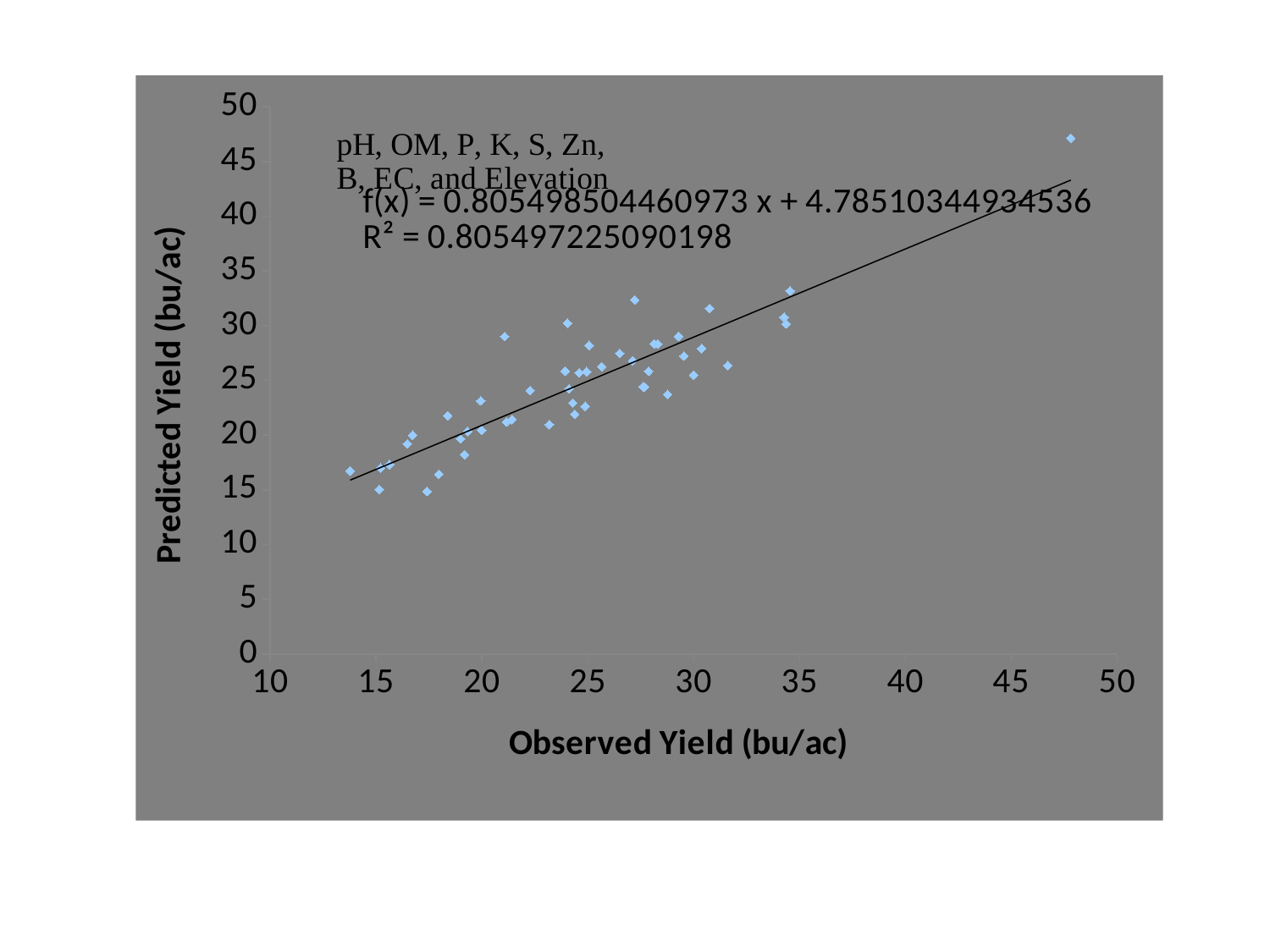
What is the title of the y axis? Predicted Yield (bu/ac) What is the intercept of the fitted line shown in the equation on the chart? 4.78510344934536 Is the lowest observed yield plotted greater or less than 15? less Is the observed yield of the rightmost point greater or less than 45? greater What R² value is printed on the chart? 0.805497225090198 Is the predicted yield of the point with the highest observed yield greater or less than 45? greater What is the maximum value shown on the x axis? 50 Does predicted yield rise or fall as observed yield increases along the x axis? rise What is the title of the x axis? Observed Yield (bu/ac) What is the slope of the fitted line shown in the equation on the chart? 0.805498504460973 What kind of chart is shown on the slide? scatter plot